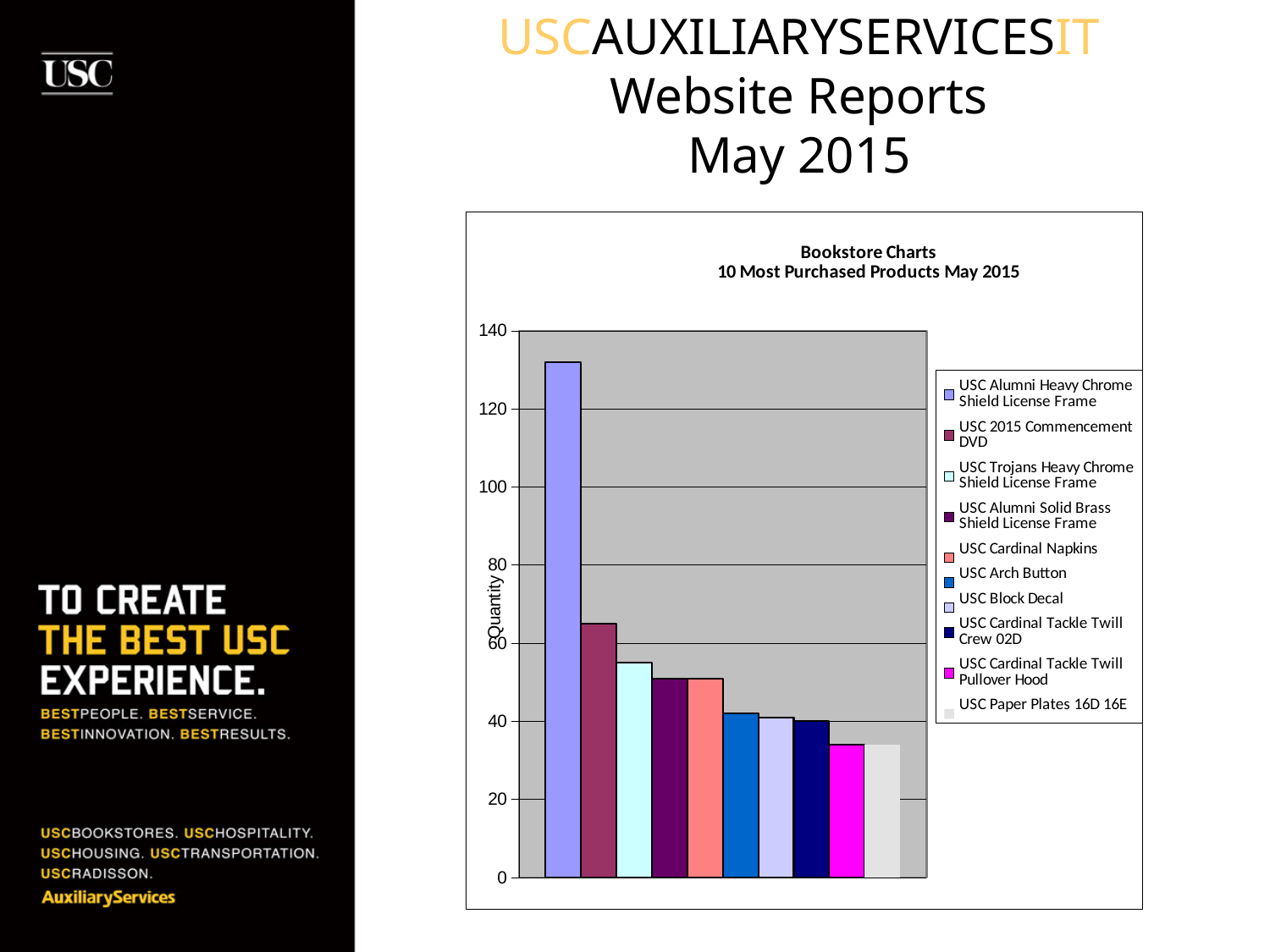
Is the value for USC Paper Plates 16D 16E greater or less than 40? less What is the title of the chart? Bookstore Charts 10 Most Purchased Products May 2015 Which is larger, the value for USC 2015 Commencement DVD or USC Trojans Heavy Chrome Shield License Frame? USC 2015 Commencement DVD How many series does the legend list? 10 Is the value for USC Alumni Heavy Chrome Shield License Frame greater or less than 120? greater Do the bar values rise or fall from left to right across the chart? fall What kind of chart is shown on the slide? bar chart Is the value for USC Cardinal Napkins greater or less than 60? less What is the label on the vertical axis of the chart? Quantity Which product has the highest quantity? USC Alumni Heavy Chrome Shield License Frame How many bars are plotted in the chart? 10